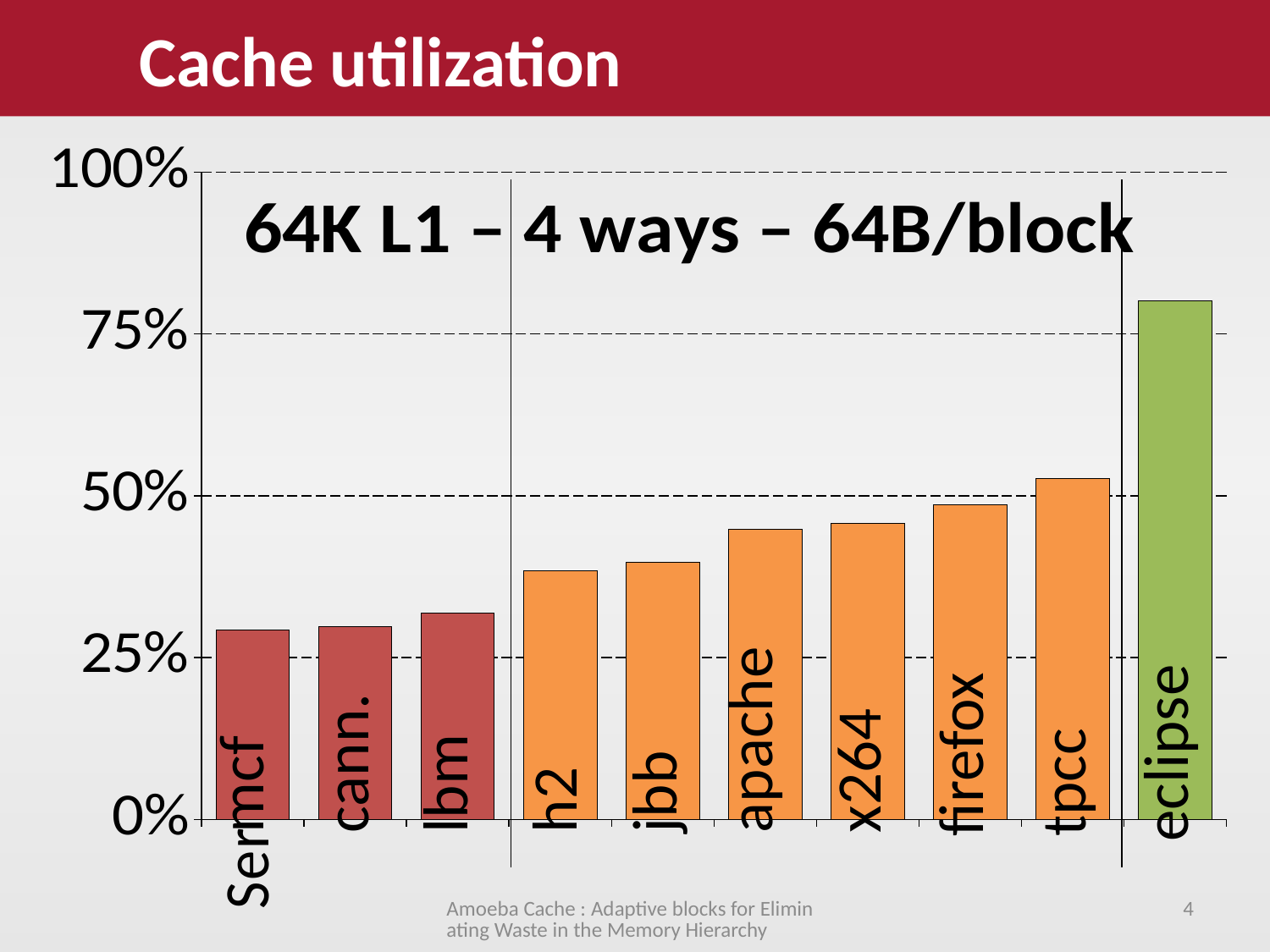
Is the value for h2 greater or less than 50%? less How many categories (bars) are plotted in the chart? 10 Which is larger, the value for apache or the value for h2? apache Is the value for firefox greater or less than 50%? less Is the value for tpcc greater or less than 50%? greater What kind of chart is shown on the slide? bar chart Which is larger, the value for lbm or the value for jbb? jbb What cache configuration is stated in the text annotation inside the chart? 64K L1 – 4 ways – 64B/block Do the bar values generally rise or fall from left to right along the x axis? rise Which category has the highest cache utilization? eclipse